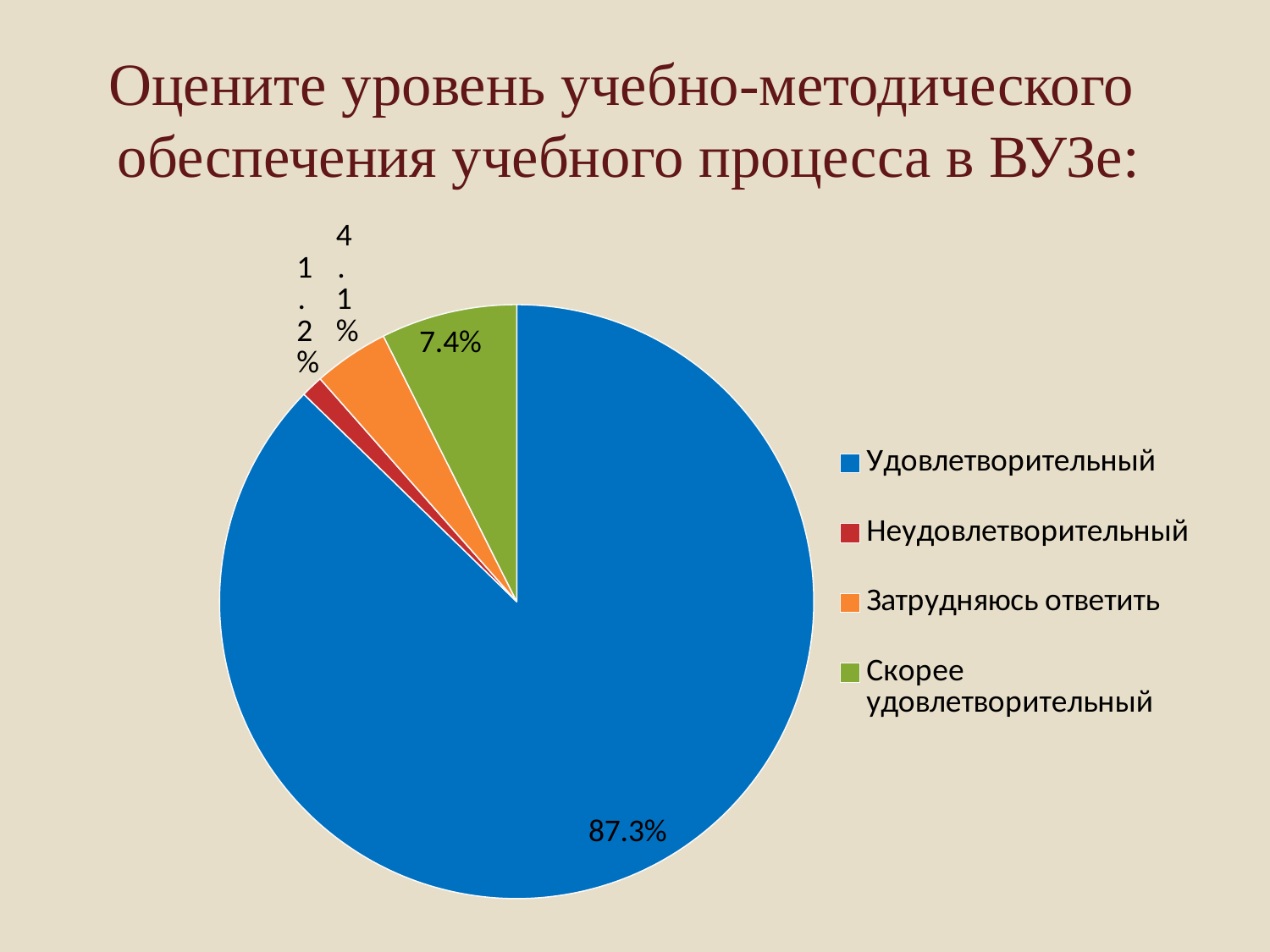
What share of the pie does Неудовлетворительный have? 1.2% Which category has the largest slice of the pie? Удовлетворительный What share of the pie does Скорее удовлетворительный have? 7.4% How many categories does the pie chart have? 4 What colour is the slice for Затрудняюсь ответить? orange What share of the pie does Удовлетворительный have? 87.3% Which is larger, the slice for Скорее удовлетворительный or the slice for Затрудняюсь ответить? Скорее удовлетворительный What kind of chart is shown on the slide? pie chart What is the title of the slide containing the pie chart? Оцените уровень учебно-методического обеспечения учебного процесса в ВУЗе: What share of the pie does Затрудняюсь ответить have? 4.1% What is the difference between the shares for Скорее удовлетворительный and Затрудняюсь ответить? 3.3% Which category has the smallest slice of the pie? Неудовлетворительный